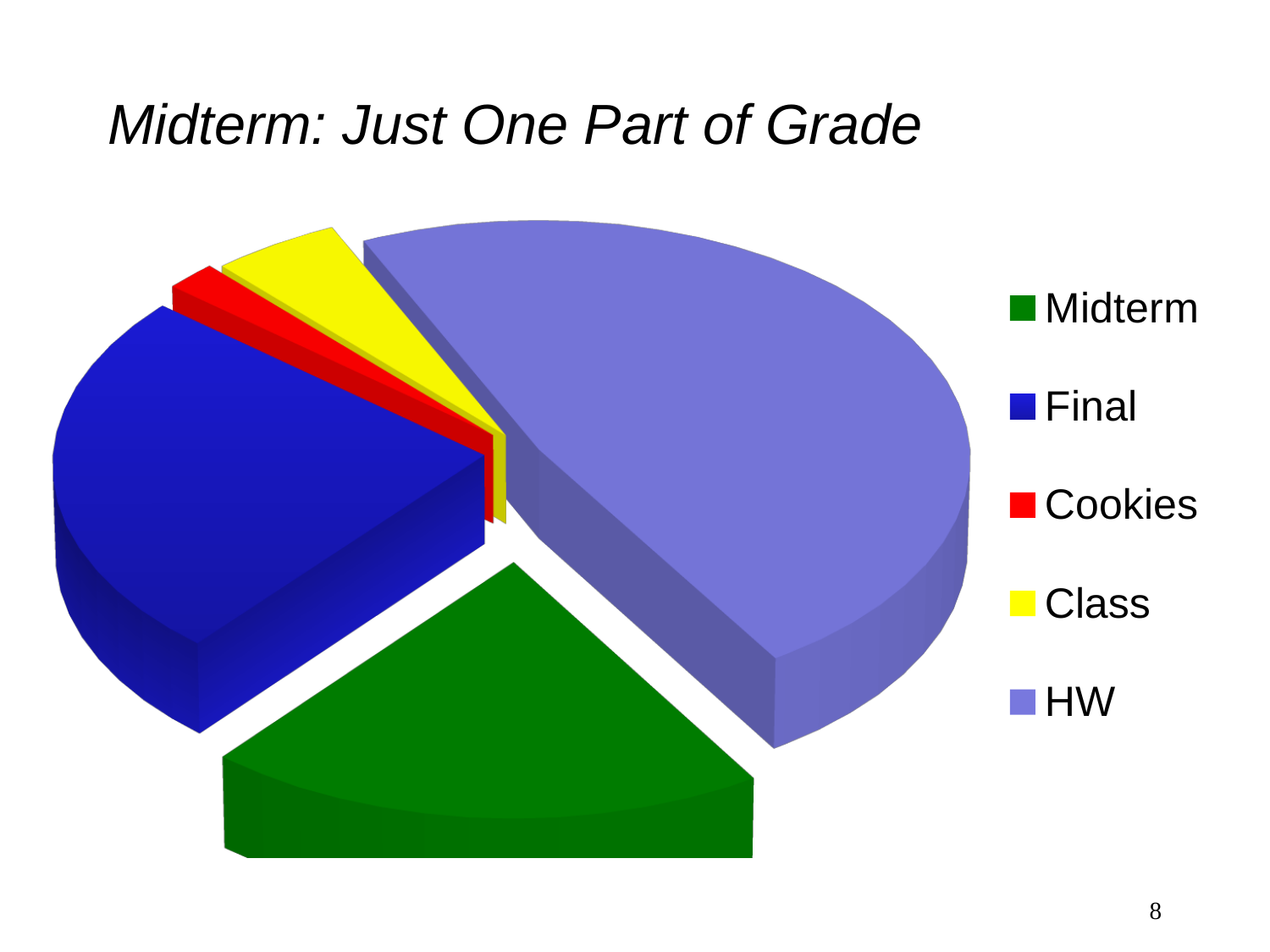
How many categories are shown in the pie chart? 5 Which slice is larger, Final or Class? Final Which slice is larger, Midterm or Cookies? Midterm What colour is the Midterm slice in the pie chart? green Which category has the largest slice of the pie? HW How many entries does the legend list? 5 What is the title of the slide containing the chart? Midterm: Just One Part of Grade Which category has the smallest slice of the pie? Cookies What kind of chart is shown on the slide? pie chart Which slice is larger, HW or Midterm? HW